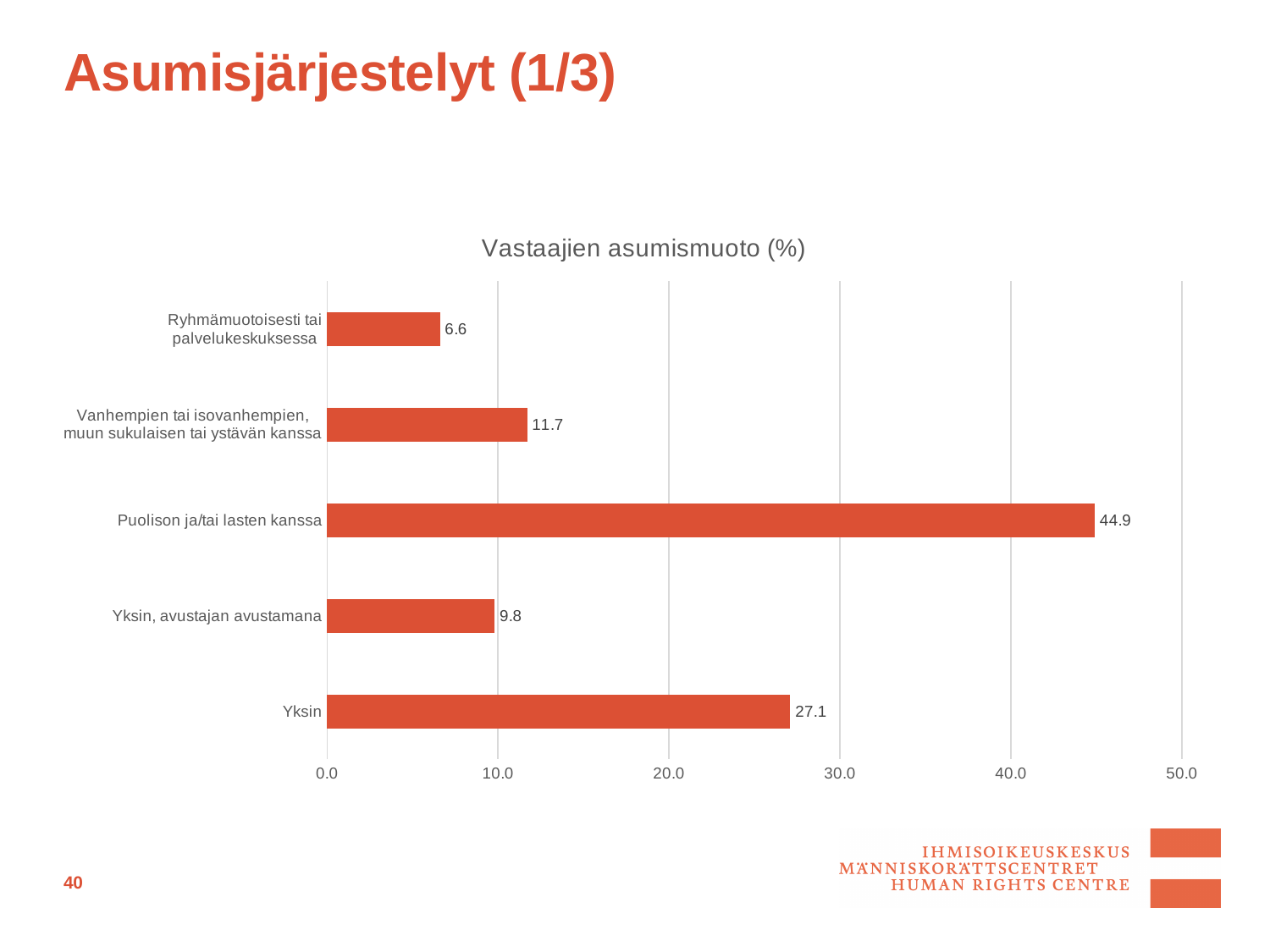
What is the value for "Puolison ja/tai lasten kanssa"? 44.9 Is the value for "Yksin" greater or less than 30.0? less What is the value for "Ryhmämuotoisesti tai palvelukeskuksessa"? 6.6 What is the value for "Yksin"? 27.1 How many categories are shown in the chart? 5 What is the value for "Yksin, avustajan avustamana"? 9.8 Which is larger: the value for "Vanhempien tai isovanhempien, muun sukulaisen tai ystävän kanssa" or for "Yksin, avustajan avustamana"? Vanhempien tai isovanhempien, muun sukulaisen tai ystävän kanssa What is the difference between the values for "Puolison ja/tai lasten kanssa" and "Yksin"? 17.8 Which category has the highest value? Puolison ja/tai lasten kanssa What is the title of the chart? Vastaajien asumismuoto (%) What kind of chart is shown on the slide? bar chart Which category has the lowest value? Ryhmämuotoisesti tai palvelukeskuksessa